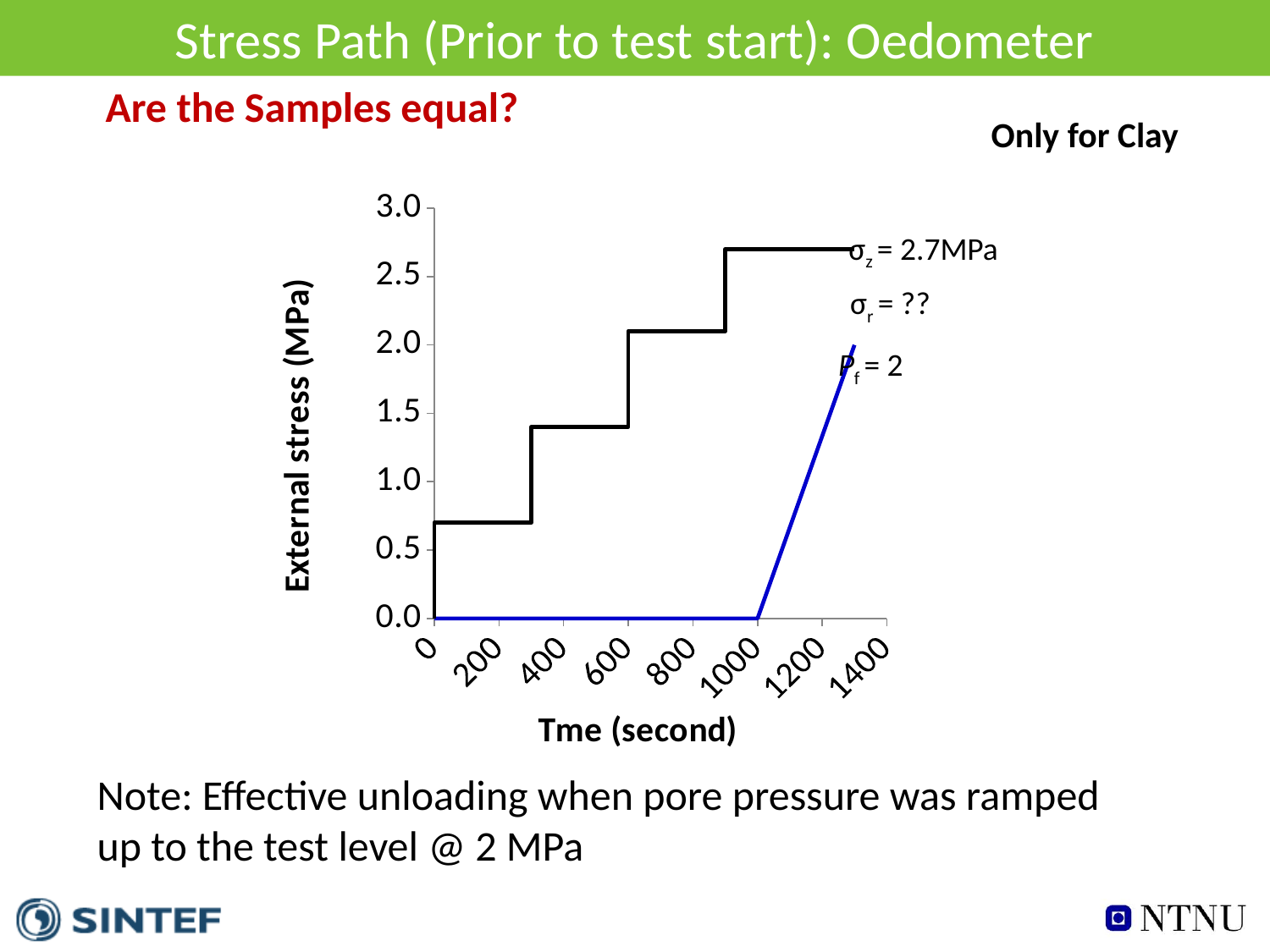
What is the final value reached by the black step line, as labelled on the chart (σz)? 2.7MPa How many plateaus (steps) does the black step line have? 4 Is the value of the black line at 1200 seconds greater or less than 2.5? greater What is the value of the blue line at 600 seconds? 0.0 Is the value of the black line at 100 seconds greater or less than 1.0? less What is the title of the x axis of the chart? Tme (second) Does the black step line rise or fall as time increases? rise At 1200 seconds, which line has the higher value, the black line or the blue line? black line Is the value of the black line at 500 seconds greater or less than 1.0? greater What kind of chart is shown on the slide? line chart What value does the blue line reach at its end, as labelled on the chart (Pf)? 2 What is the title of the y axis of the chart? External stress (MPa)